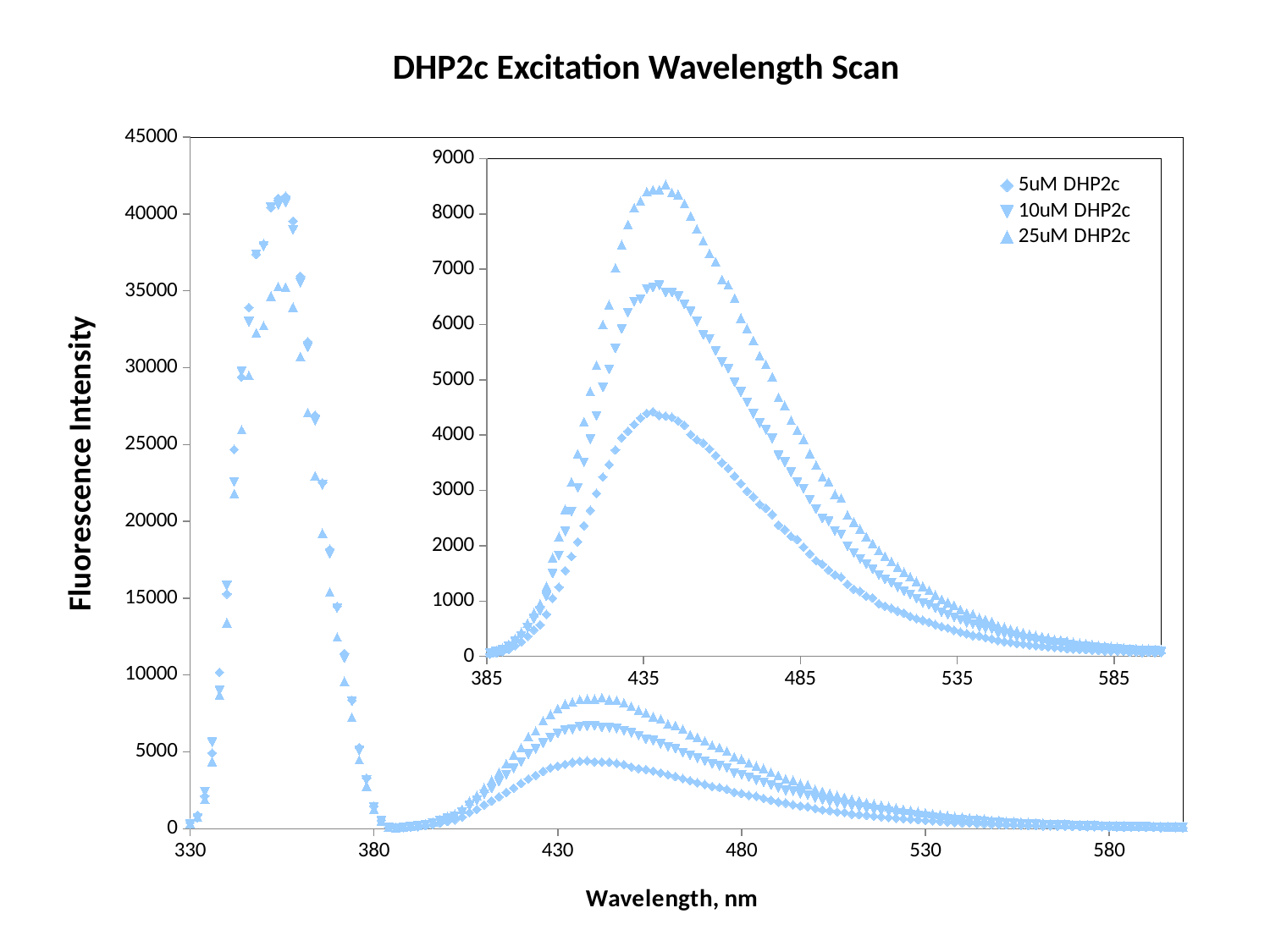
In the inset chart, is the peak value for 5uM DHP2c greater or less than 5000? less In the inset chart, which series has the lowest peak fluorescence intensity? 5uM DHP2c What kind of chart is the main chart on the slide? scatter chart What is the title of the chart on the slide? DHP2c Excitation Wavelength Scan In the inset chart, at around 435 nm, which series has the larger value: 10uM DHP2c or 5uM DHP2c? 10uM DHP2c In the inset chart, is the peak value for 25uM DHP2c greater or less than 8000? greater In the inset chart, do the values for 25uM DHP2c rise or fall as wavelength increases from 485 nm to 585 nm? fall What is the label of the y axis on the main chart? Fluorescence Intensity In the inset chart, is the peak value for 10uM DHP2c greater or less than 6000? greater How many series does the legend of the inset chart list? 3 In the inset chart, which series reaches the highest fluorescence intensity? 25uM DHP2c